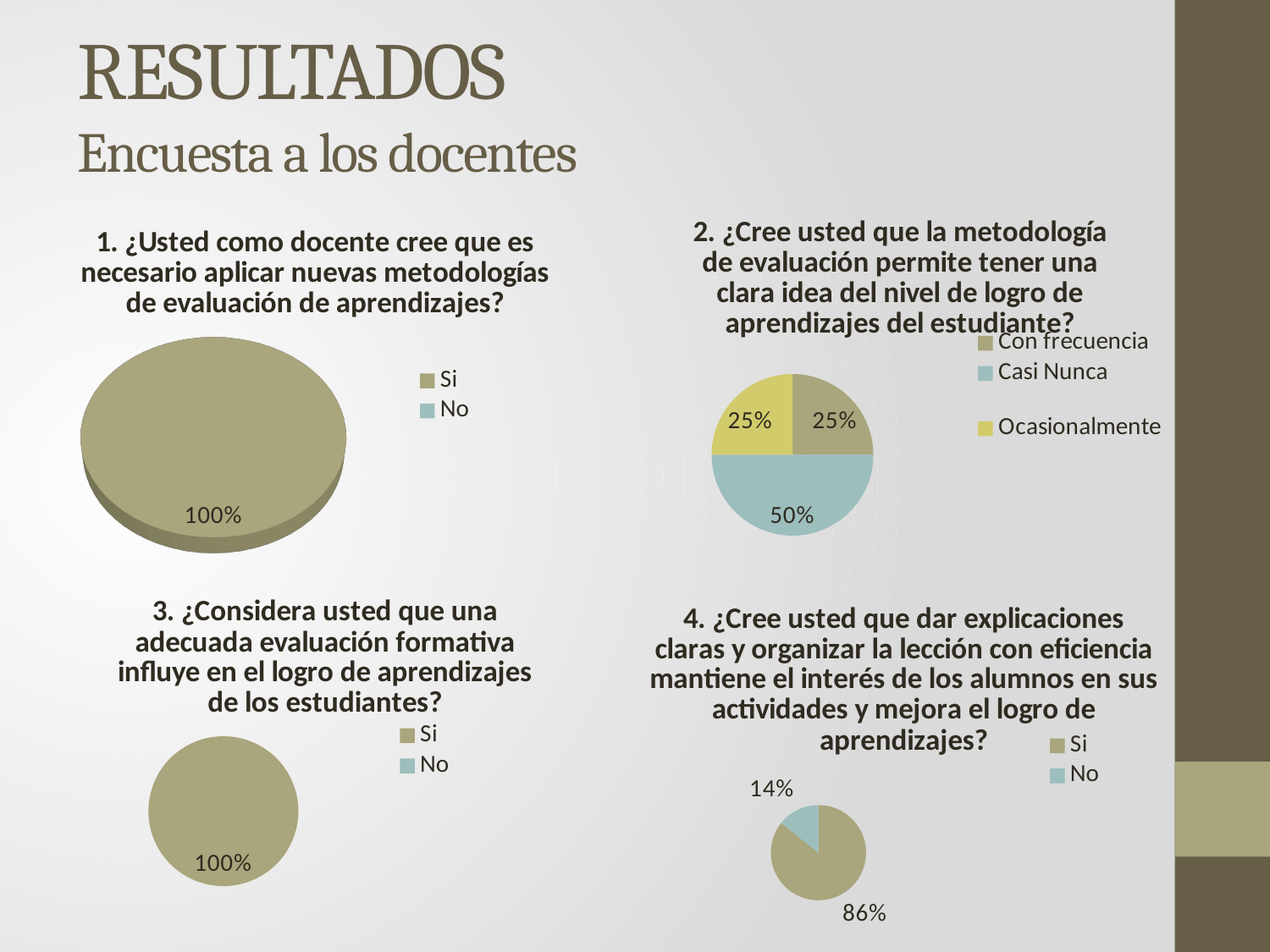
In the bottom-right pie chart (question 4), what percentage of teachers answered 'No'? 14% In the bottom-right pie chart (question 4), which answer has the smaller share? No In the top-right pie chart (question 2), how many categories does the legend list? 3 In the bottom-right pie chart (question 4), what is the difference between the 'Si' share and the 'No' share? 72% In the bottom-right pie chart (question 4), what percentage of teachers answered 'Si'? 86% In the top-left pie chart (question 1), what percentage of teachers answered 'Si'? 100% In the bottom-left pie chart (question 3), what percentage is shown for 'Si'? 100% In the top-right pie chart (question 2), what share is labelled for 'Con frecuencia'? 25% In the top-right pie chart (question 2), which category has the largest share? Casi Nunca What type of chart is used for all four questions on the slide? Pie chart In the top-right pie chart (question 2), what is the difference between the 'Casi Nunca' share and the 'Ocasionalmente' share? 25% In the top-right pie chart (question 2), what share is labelled for 'Casi Nunca'? 50%